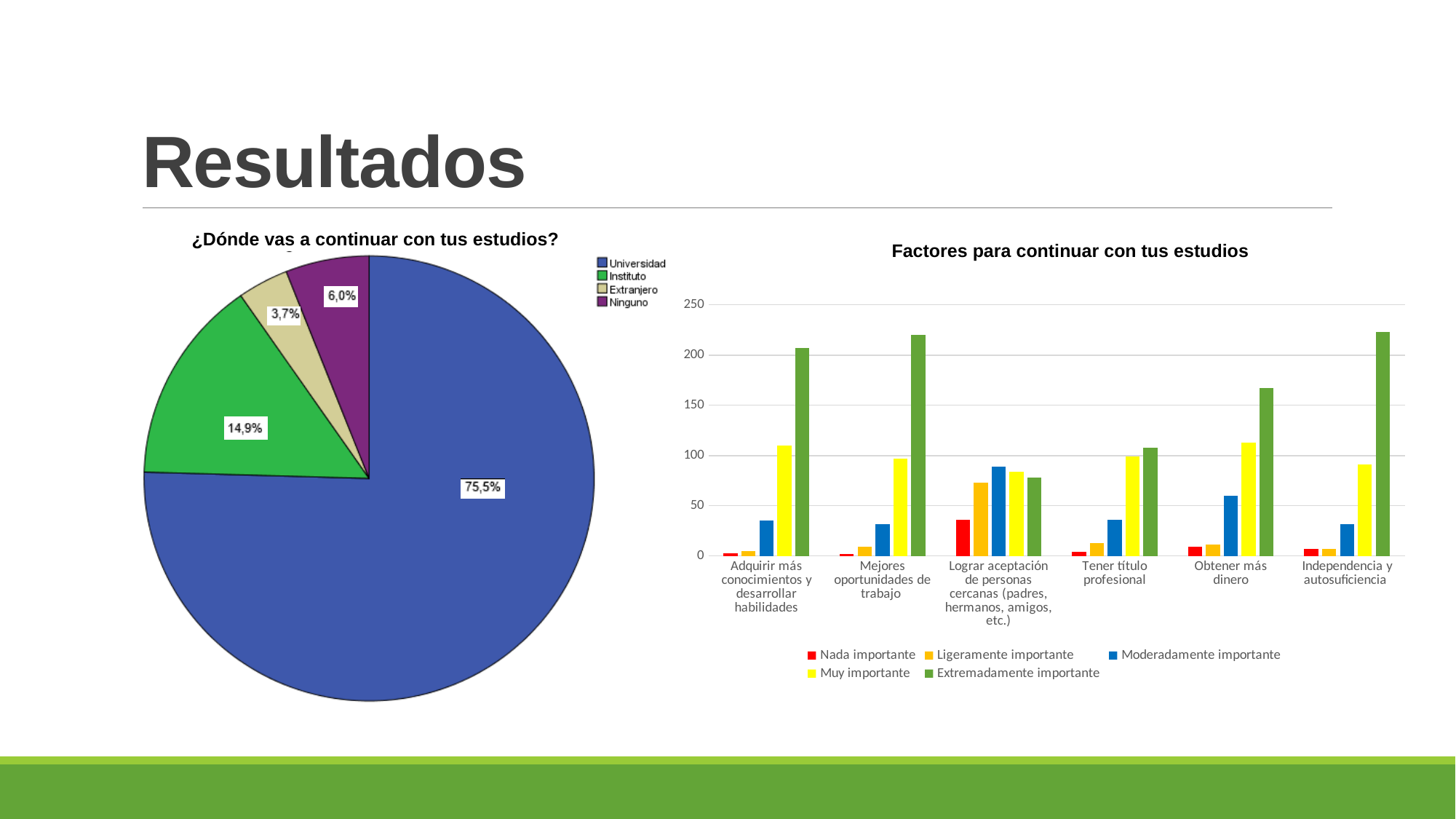
In 'Factores para continuar con tus estudios', is the value of Extremadamente importante for 'Lograr aceptación de personas cercanas' greater or less than 100? less In the pie chart '¿Dónde vas a continuar con tus estudios?', what is the difference in percentage points between Universidad and Instituto? 60,6 How many series does the legend of 'Factores para continuar con tus estudios' list? 5 In the pie chart '¿Dónde vas a continuar con tus estudios?', which is larger, Ninguno or Extranjero? Ninguno How many categories does the pie chart '¿Dónde vas a continuar con tus estudios?' show? 4 In 'Factores para continuar con tus estudios', which series is represented by the green bars? Extremadamente importante How many categories are shown on the x axis of 'Factores para continuar con tus estudios'? 6 In 'Factores para continuar con tus estudios', is the value of Extremadamente importante for 'Mejores oportunidades de trabajo' greater or less than 200? greater In the pie chart '¿Dónde vas a continuar con tus estudios?', what share is shown for Universidad? 75,5% In the pie chart '¿Dónde vas a continuar con tus estudios?', what share is shown for Instituto? 14,9% In the pie chart '¿Dónde vas a continuar con tus estudios?', which category has the smallest slice? Extranjero What kind of chart is 'Factores para continuar con tus estudios'? Bar chart